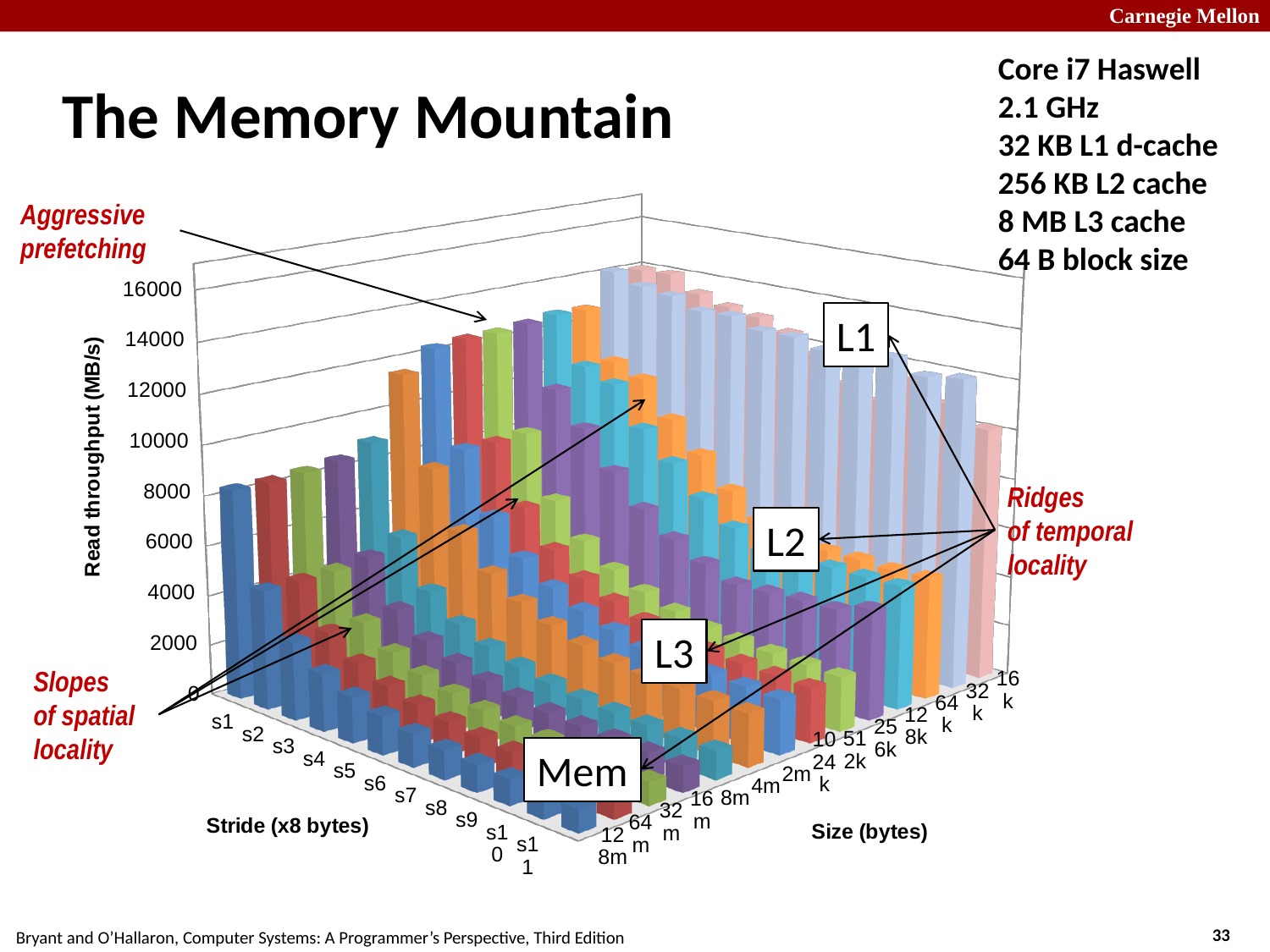
For a fixed working-set size, does read throughput generally rise or fall as the stride increases from s1 to s11? fall Is the read throughput for stride s1 at size 16k greater or less than 12000? greater What is the highest tick value shown on the vertical axis? 16000 What is the label of the stride axis? Stride (x8 bytes) What is the title of the slide containing the chart? The Memory Mountain How many stride categories (s1 through s11) are shown on the stride axis? 11 Is the read throughput for stride s11 at size 8m greater or less than 2000? less What kind of chart is shown on the slide? 3D bar chart What is the label of the vertical axis of the chart? Read throughput (MB/s) Which is larger: the read throughput at stride s1 for size 16k or at stride s1 for size 8m? 16k What is the interval between consecutive tick marks on the vertical axis? 2000